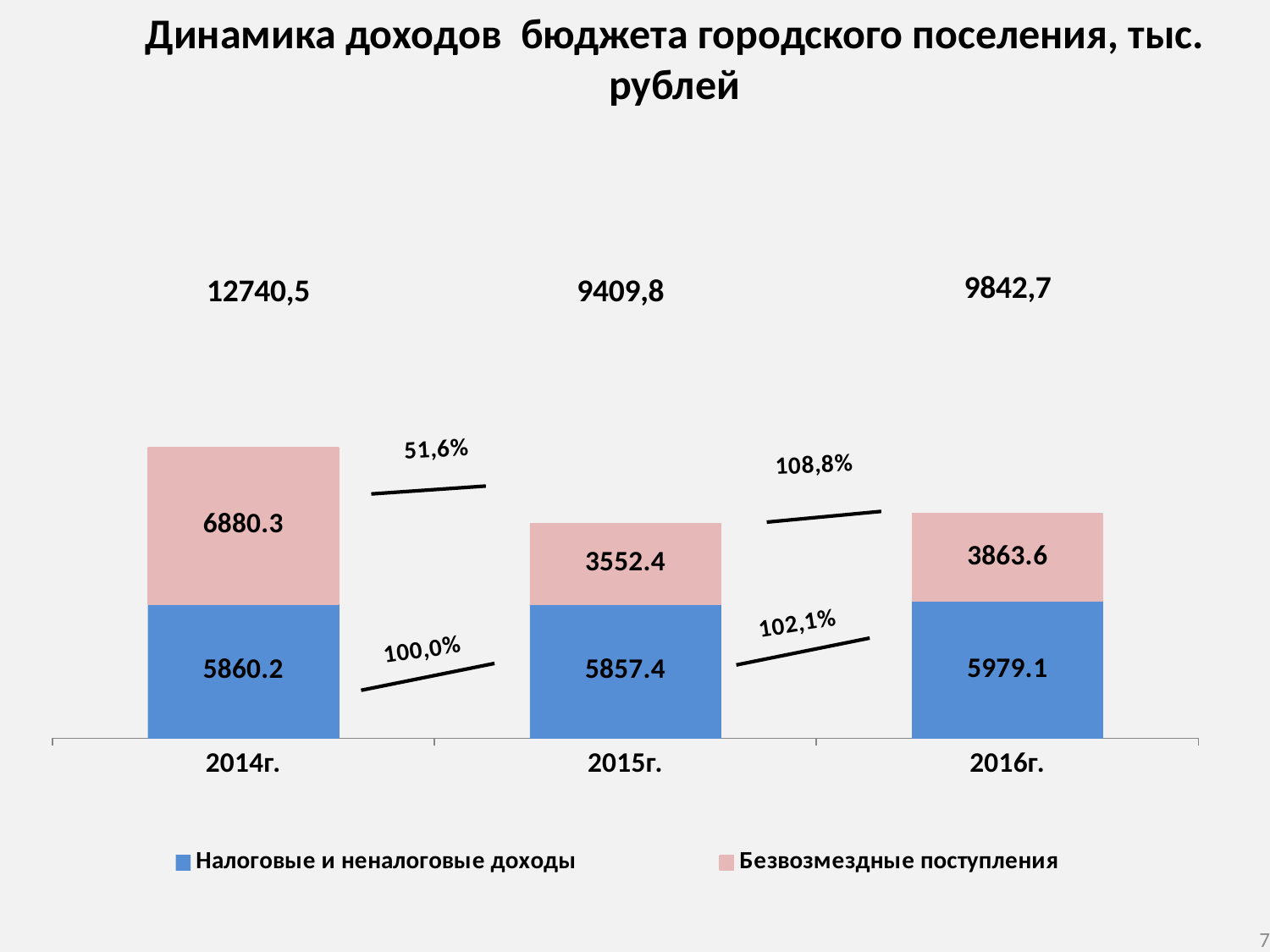
What is the value of Налоговые и неналоговые доходы for 2014г.? 5860.2 What type of chart is shown on the slide? Stacked bar chart Which year has the lowest value for Налоговые и неналоговые доходы? 2015г. Which is larger: Налоговые и неналоговые доходы in 2016г. or in 2014г.? 2016г. What is the value of Безвозмездные поступления for 2015г.? 3552.4 What is the value of Безвозмездные поступления for 2016г.? 3863.6 Which year has the highest value for Безвозмездные поступления? 2014г. What is the total budget income shown above the bar for 2014г.? 12740,5 How many series does the legend list? 2 What is the difference between Безвозмездные поступления in 2016г. and 2015г.? 311.2 How many years are shown on the x axis? 3 What is the total budget income shown above the bar for 2016г.? 9842,7